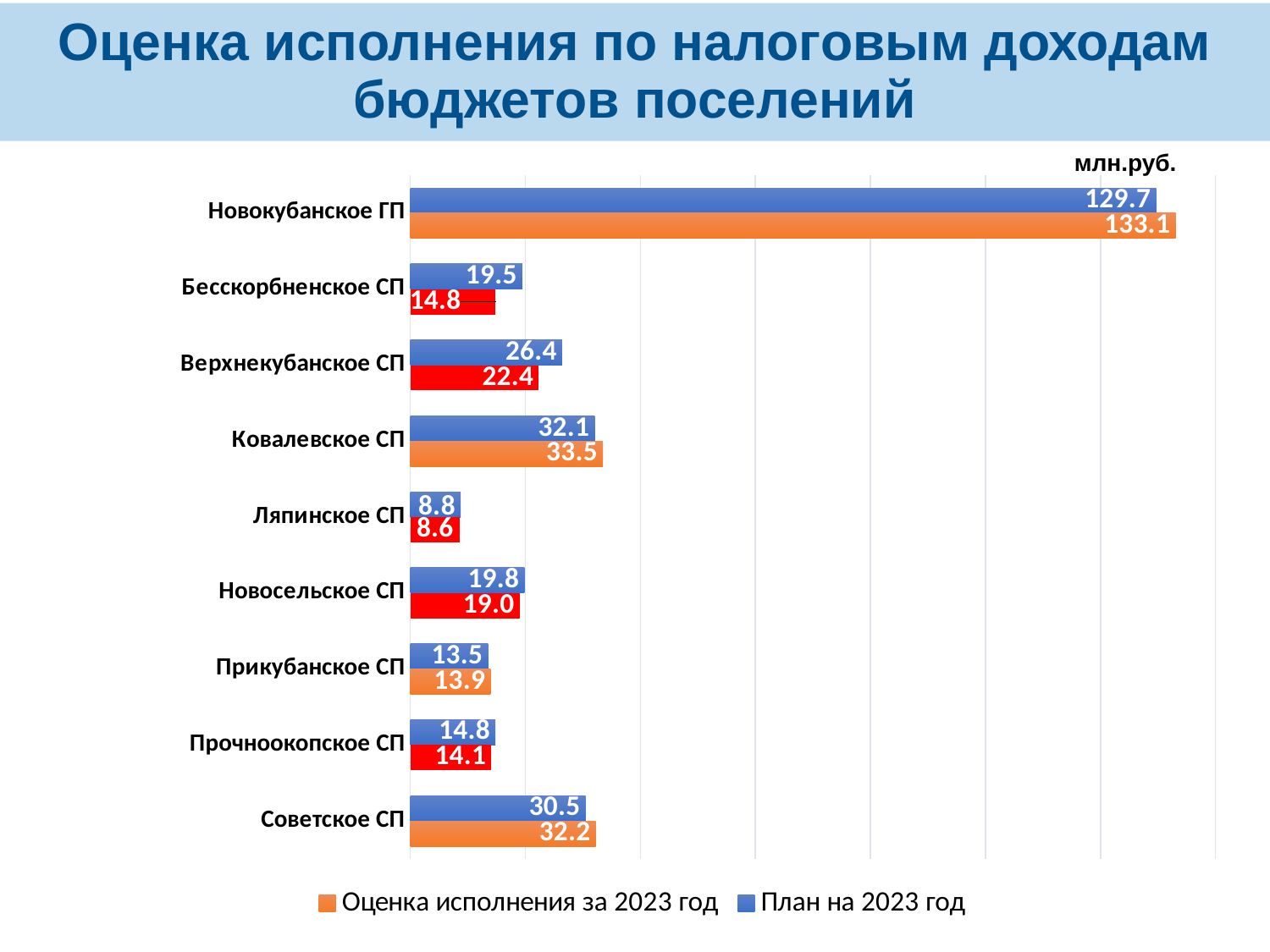
What kind of chart is shown on the slide? Bar chart Which category has the highest value for "Оценка исполнения за 2023 год"? Новокубанское ГП What is the value of "Оценка исполнения за 2023 год" for Бесскорбненское СП? 14.8 How many categories (settlements) are shown in the chart? 9 For Прочноокопское СП, which is larger: "План на 2023 год" or "Оценка исполнения за 2023 год"? План на 2023 год What is the value of "План на 2023 год" for Новокубанское ГП? 129.7 What is the difference between "План на 2023 год" and "Оценка исполнения за 2023 год" for Верхнекубанское СП? 4.0 For Советское СП, which is larger: "План на 2023 год" or "Оценка исполнения за 2023 год"? Оценка исполнения за 2023 год What is the difference between "Оценка исполнения за 2023 год" and "План на 2023 год" for Новокубанское ГП? 3.4 What is the value of "Оценка исполнения за 2023 год" for Ковалевское СП? 33.5 How many series does the legend list? 2 Which category has the lowest value for "План на 2023 год"? Ляпинское СП